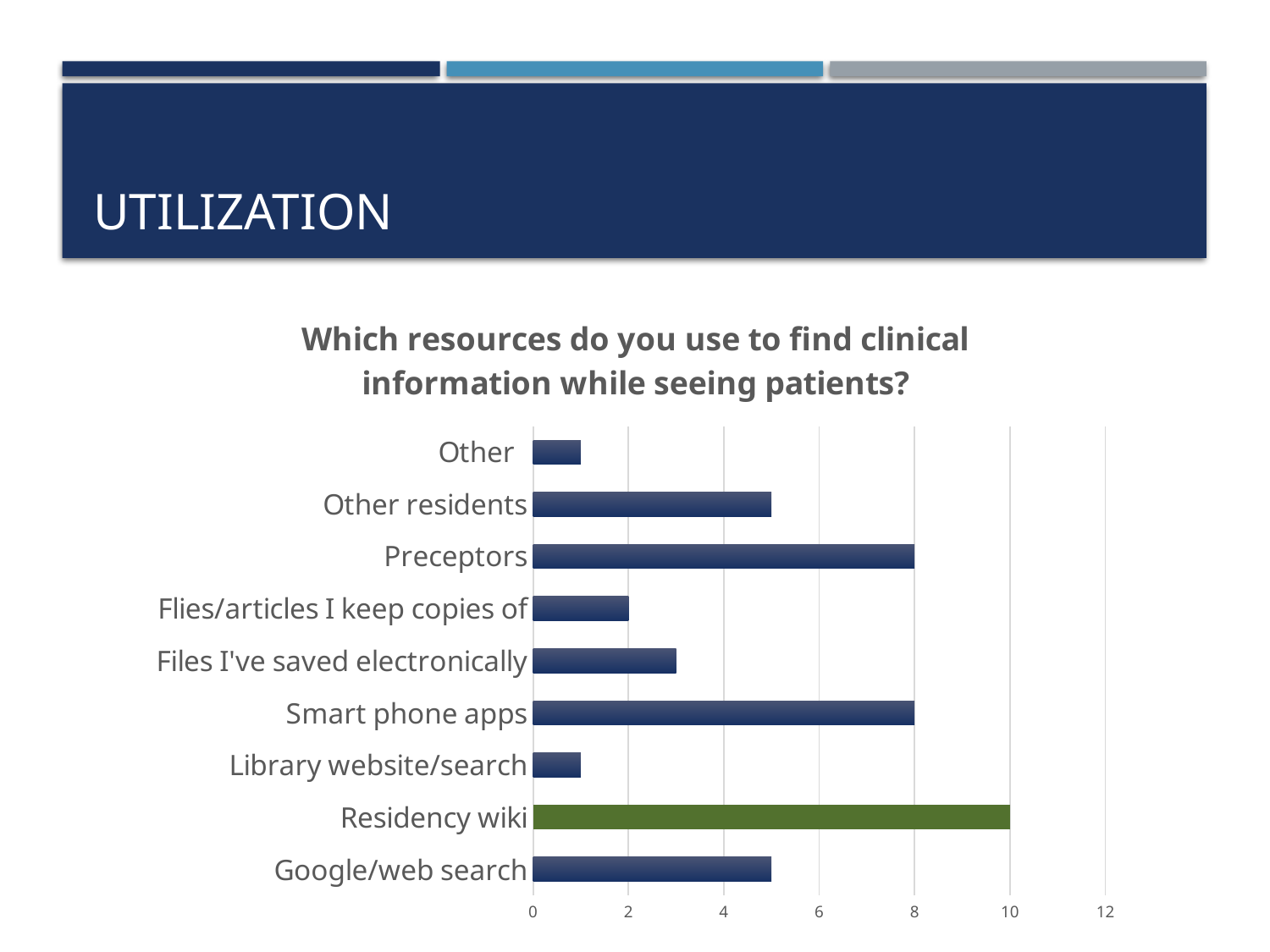
What is the value for Smart phone apps? 8 Which is larger, the value for Residency wiki or the value for Smart phone apps? Residency wiki Which resource has the highest value? Residency wiki How many resource categories are shown in the chart? 9 What is the value for Residency wiki? 10 What is the value for Preceptors? 8 What is the difference between the values for Residency wiki and Preceptors? 2 Is the value for Files I've saved electronically greater or less than 4? less What is the value for Flies/articles I keep copies of? 2 Which bar is coloured green rather than dark blue? Residency wiki What kind of chart is shown on the slide? Bar chart Is the value for Other residents greater or less than 4? greater